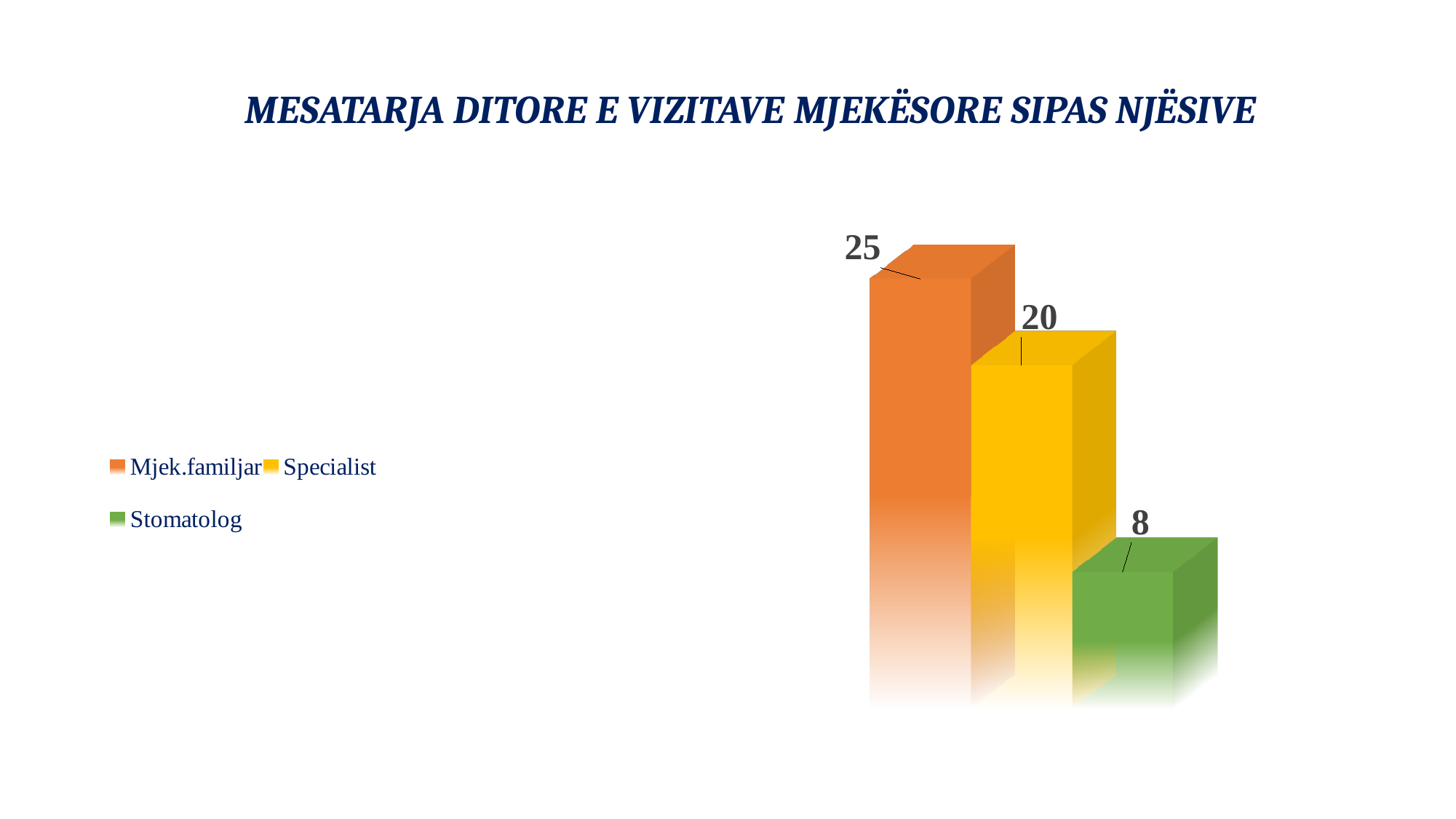
What kind of chart is shown on the slide? Bar chart What is the value for Stomatolog? 8 What is the title of the chart? MESATARJA DITORE E VIZITAVE MJEKËSORE SIPAS NJËSIVE How many series does the legend list? 3 What is the difference between the values for Mjek.familjar and Specialist? 5 What is the difference between the values for Specialist and Stomatolog? 12 How many bars are plotted on the chart? 3 Which is larger, the value for Specialist or the value for Stomatolog? Specialist What is the value for Specialist? 20 What is the value for Mjek.familjar? 25 Which series has the lowest value? Stomatolog Which series has the highest value? Mjek.familjar